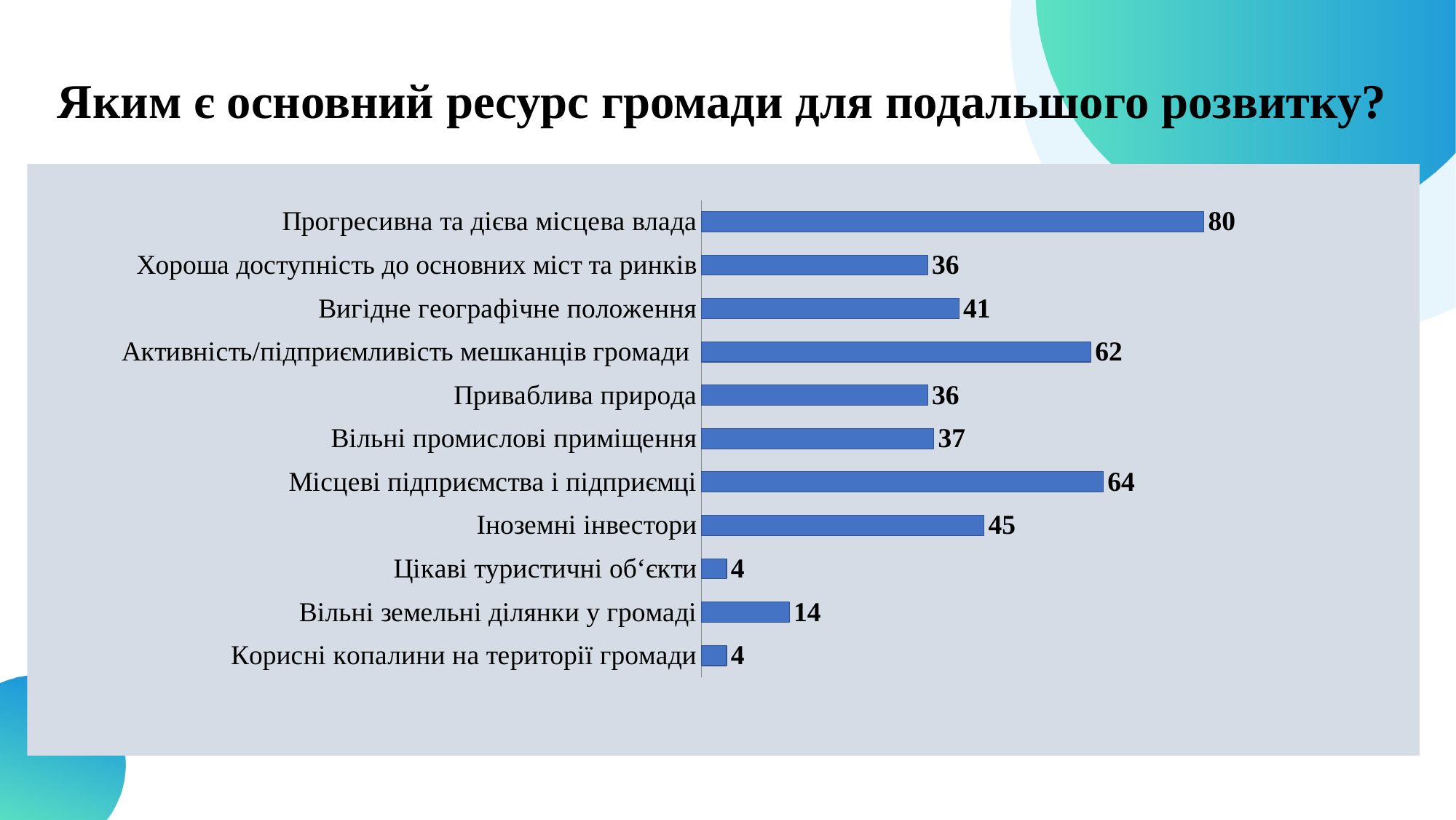
What is the title of the slide above the chart? Яким є основний ресурс громади для подальшого розвитку? What type of chart is shown on the slide? Bar chart What value is shown for "Прогресивна та дієва місцева влада"? 80 What is the difference between the values for "Місцеві підприємства і підприємці" and "Активність/підприємливість мешканців громади"? 2 How many categories are shown in the chart? 11 What value is shown for "Вигідне географічне положення"? 41 Which is larger: the value for "Вигідне географічне положення" or the value for "Хороша доступність до основних міст та ринків"? Вигідне географічне положення What value is shown for "Іноземні інвестори"? 45 What is the difference between the values for "Прогресивна та дієва місцева влада" and "Іноземні інвестори"? 35 What value is shown for "Вільні земельні ділянки у громаді"? 14 Which category has the highest value? Прогресивна та дієва місцева влада Which is larger: the value for "Вільні промислові приміщення" or the value for "Приваблива природа"? Вільні промислові приміщення